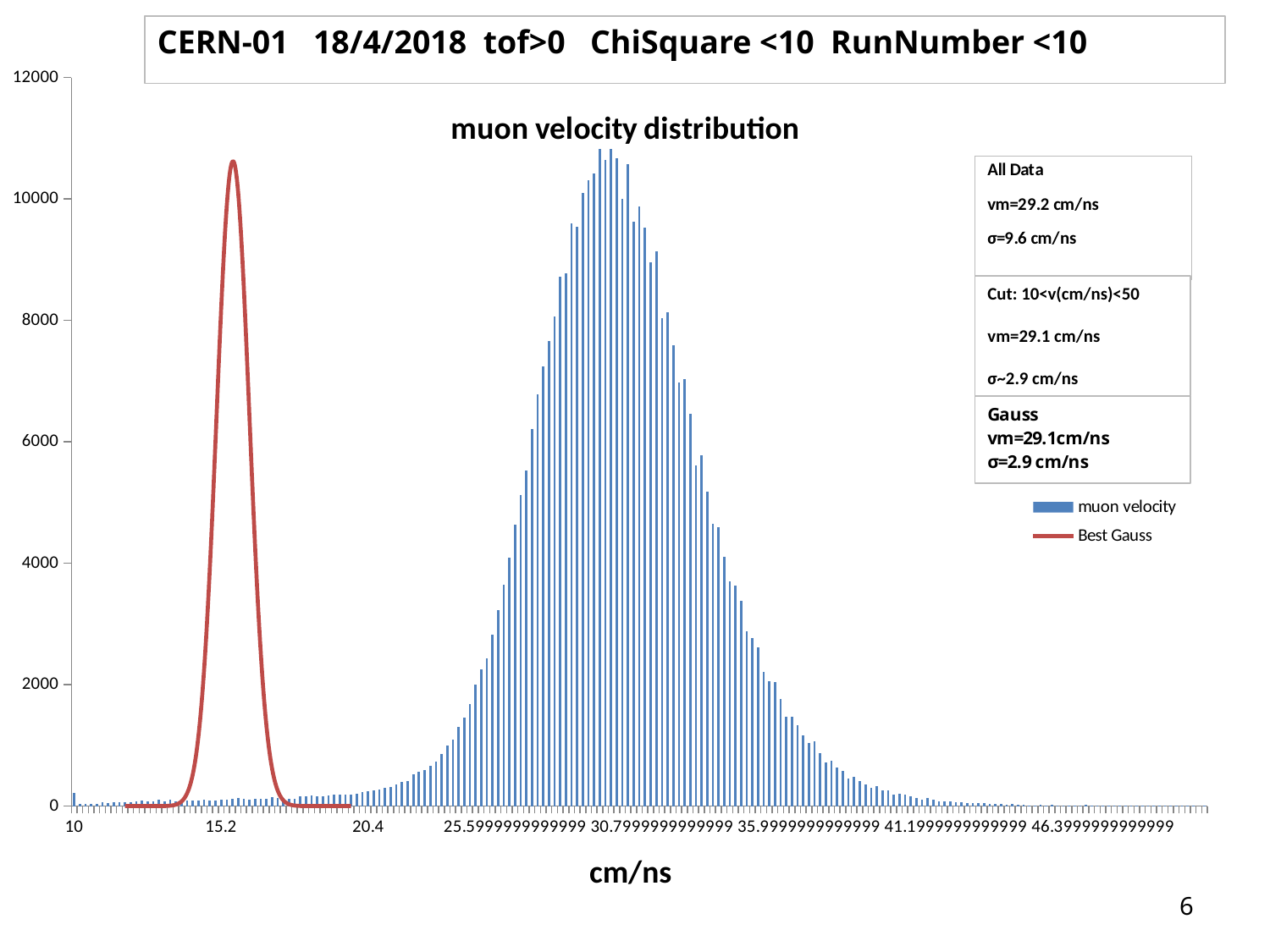
What are the two entries in the chart legend? muon velocity, Best Gauss Is the peak of the Best Gauss curve greater or less than 12000? less Is the peak of the Best Gauss curve greater or less than 8000? greater Is the muon velocity bar at 41.2 cm/ns greater or less than 2000? less What kind of chart is used to show the muon velocity data? bar chart (with a line overlay) Do the muon velocity bars rise or fall as the x axis goes from 30.8 to 36 cm/ns? fall How many series does the chart legend list? 2 What is the title of the chart? muon velocity distribution